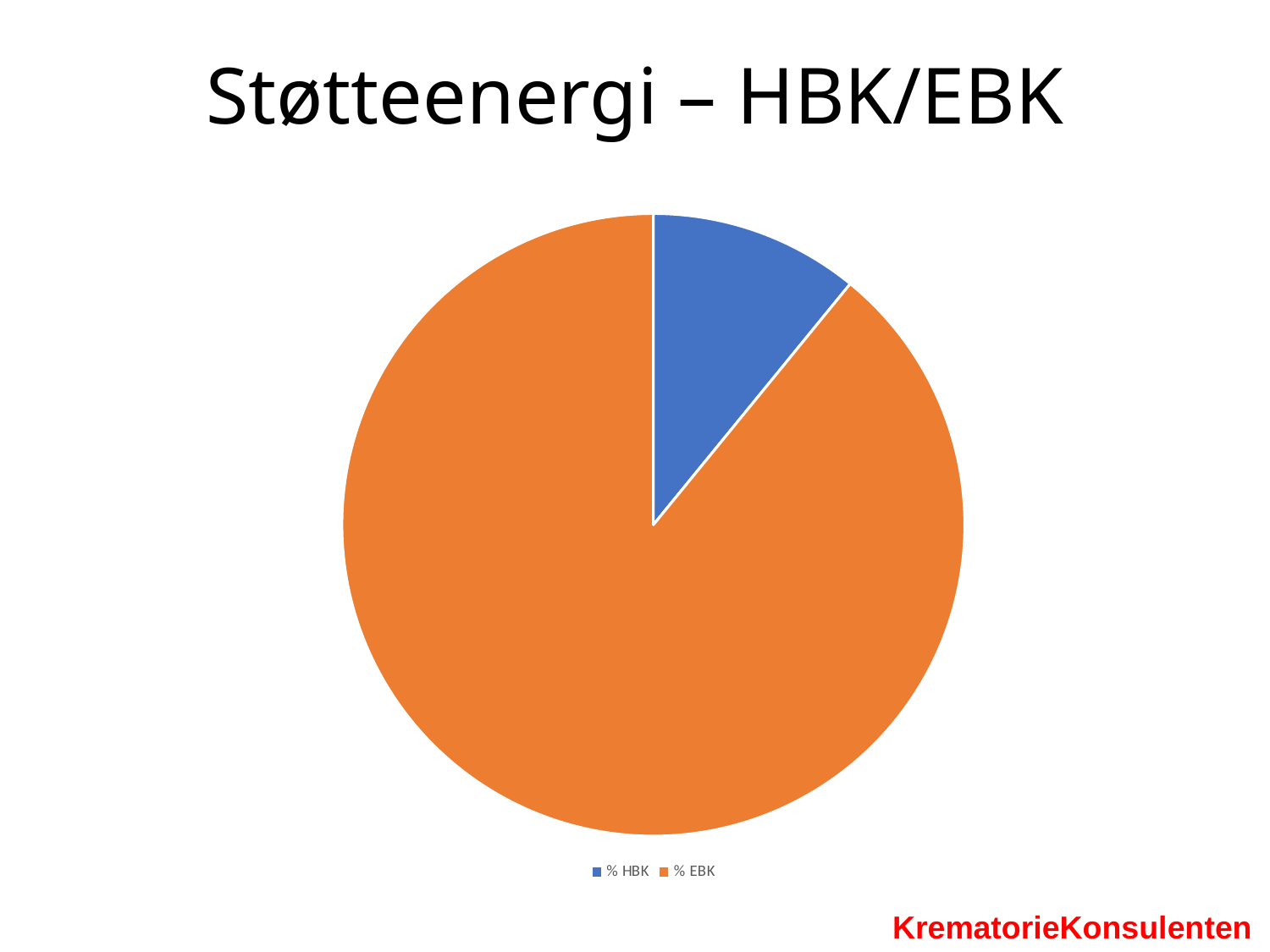
What colour is the % HBK slice in the pie chart? blue How many slices does the pie chart have? 2 Which slice of the pie chart is the largest? % EBK How many entries does the legend of the pie chart list? 2 What kind of chart is shown on the slide? pie chart Which is larger in the pie chart, % HBK or % EBK? % EBK What is the title of the slide containing the pie chart? Støtteenergi – HBK/EBK Which slice of the pie chart is the smallest? % HBK